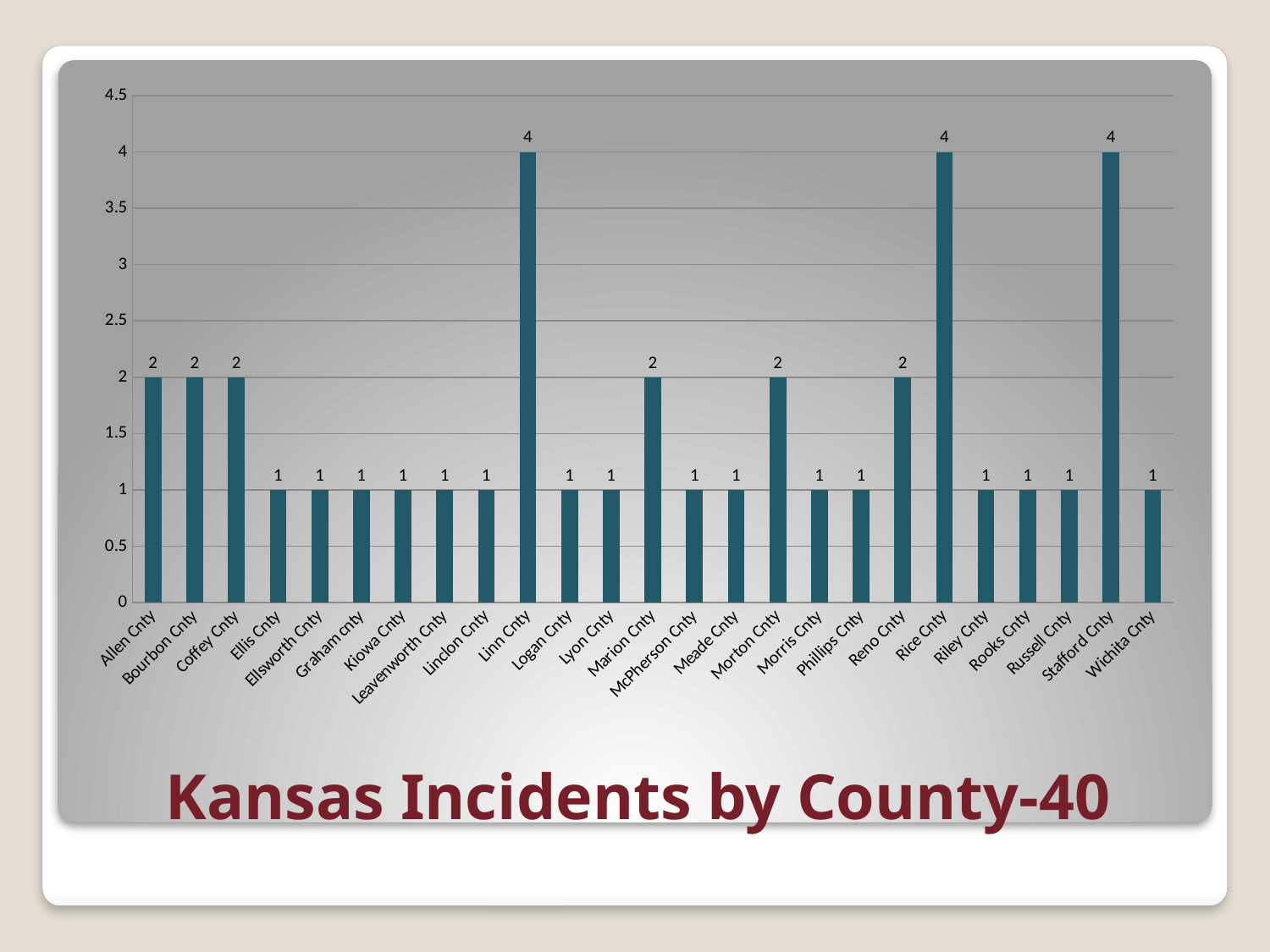
What kind of chart is shown on the slide? Bar chart Which is larger, the value for Stafford Cnty or the value for Russell Cnty? Stafford Cnty What is the difference between the values for Marion Cnty and McPherson Cnty? 1 What is the value for Wichita Cnty? 1 What is the value for Reno Cnty? 2 What is the value for Allen Cnty? 2 How many counties are shown on the chart? 25 What is the value for Linn Cnty? 4 What is the title of the chart? Kansas Incidents by County-40 Which counties have the highest value on the chart? Linn Cnty, Rice Cnty, Stafford Cnty Is the value for Morton Cnty greater or less than 1.5? greater What is the difference between the values for Rice Cnty and Riley Cnty? 3